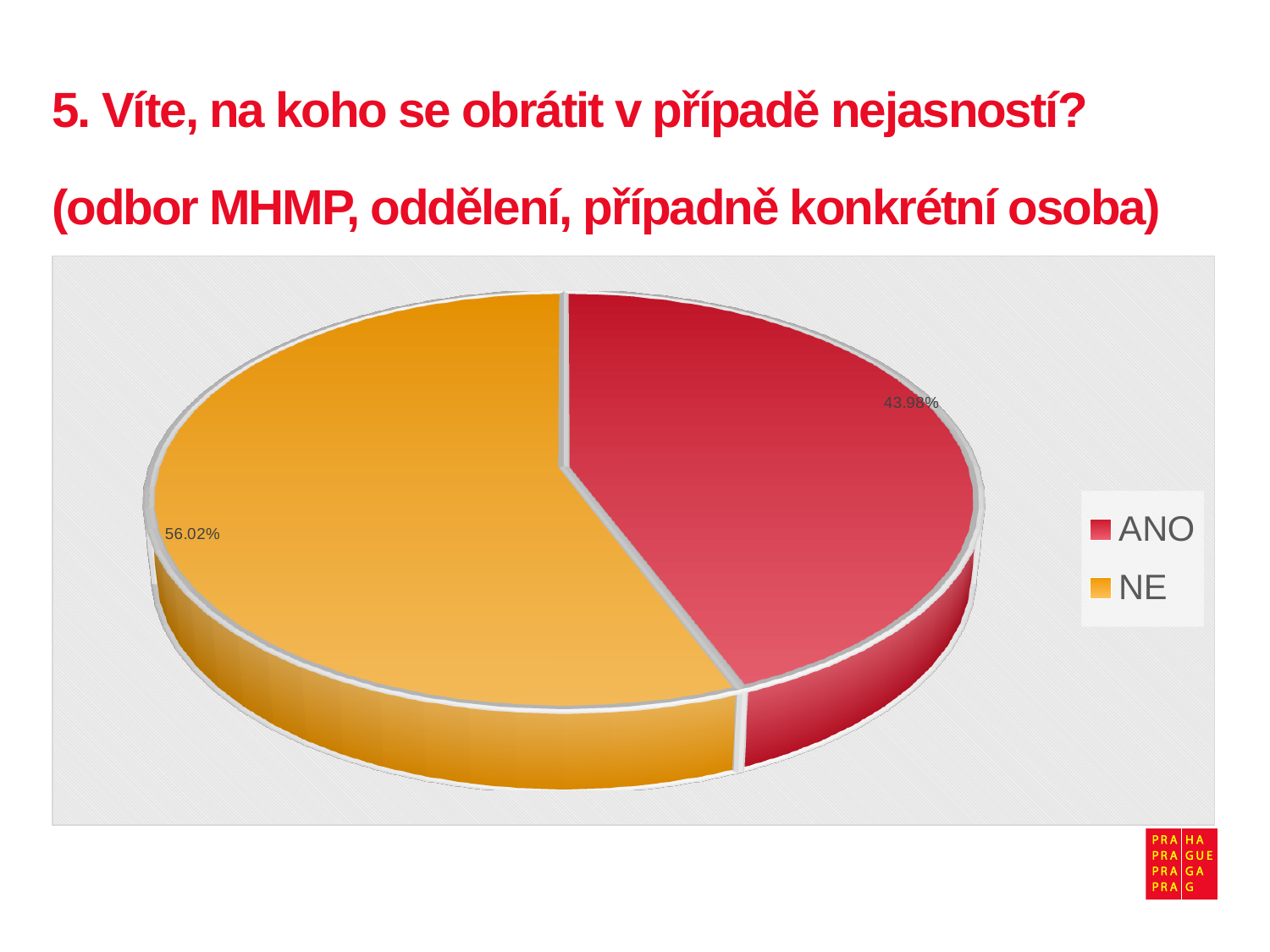
What share of the pie does the NE slice take? 56.02% What kind of chart is shown on the slide? pie chart Which slice is larger, ANO or NE? NE What is the difference in percentage points between the NE and ANO slices? 12.04 What percentage of the pie does the ANO slice represent? 43.98% Which slice is the smallest in the pie chart? ANO How many slices does the pie chart have? 2 Which slice is the largest in the pie chart? NE What colour is the NE slice in the pie chart? orange What colour is the ANO slice in the pie chart? red What percentage of the pie does the NE slice represent? 56.02% How many entries does the legend list? 2